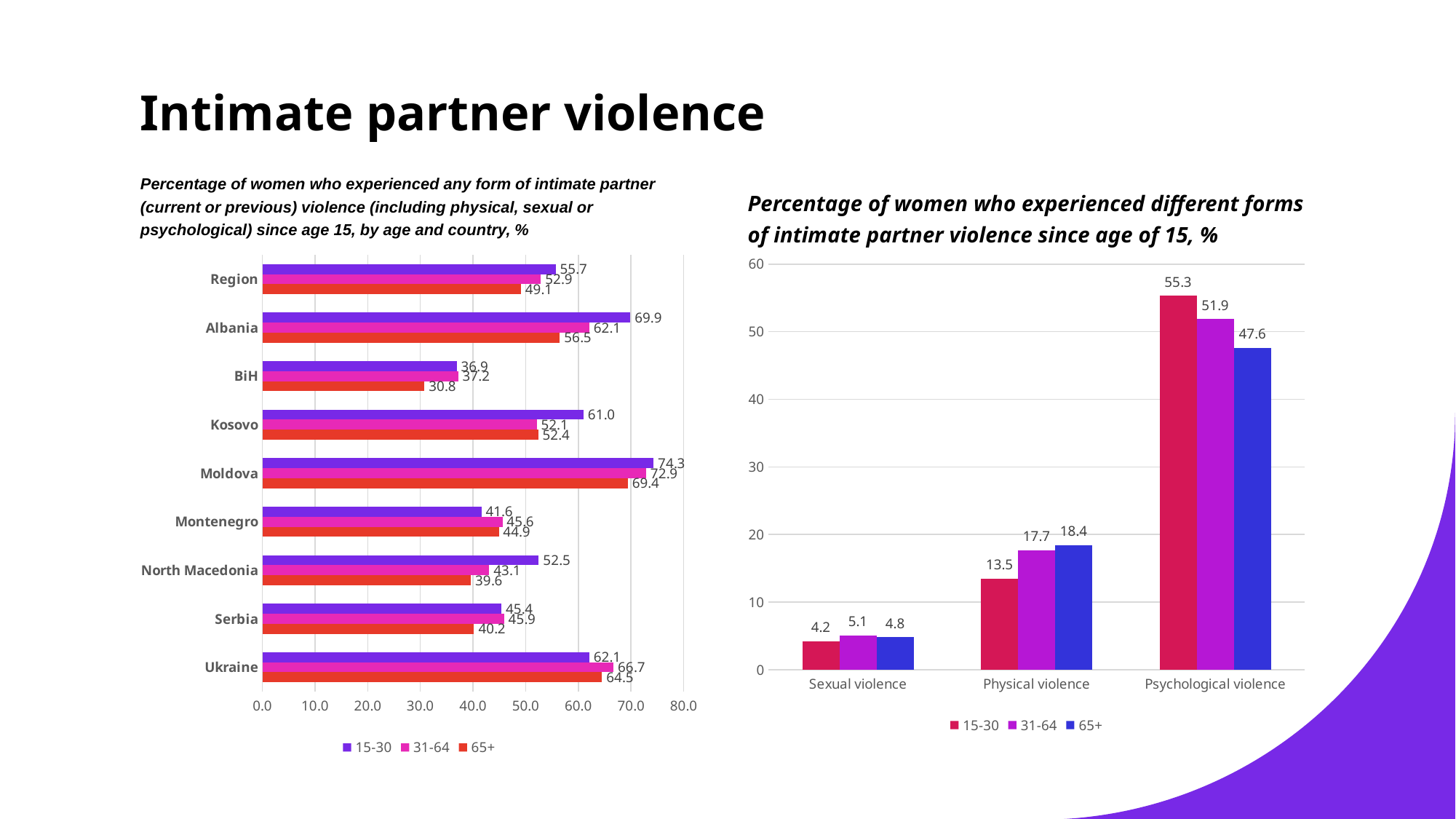
In the left chart (by age and country), which country has the highest value in the 15-30 series? Moldova In the right chart (different forms of violence), what is the value for Psychological violence in the 65+ series? 47.6 In the left chart (by age and country), which is larger for Ukraine: the 15-30 value or the 31-64 value? 31-64 In the left chart (by age and country), how many categories are shown on the vertical axis? 9 In the left chart (by age and country), what is the value for BiH in the 65+ series? 30.8 In the right chart (different forms of violence), what is the difference between the 31-64 and 15-30 values for Physical violence? 4.2 In the right chart (different forms of violence), how many series does the legend list? 3 In the right chart (different forms of violence), which form of violence has the lowest value in the 15-30 series? Sexual violence In the left chart (by age and country), which country has the lowest value in the 65+ series? BiH In the left chart (by age and country), what is the value for Albania in the 15-30 series? 69.9 In the left chart (by age and country), what is the difference between the 15-30 and 65+ values for North Macedonia? 12.9 In the left chart (by age and country), what type of chart is it? Bar chart